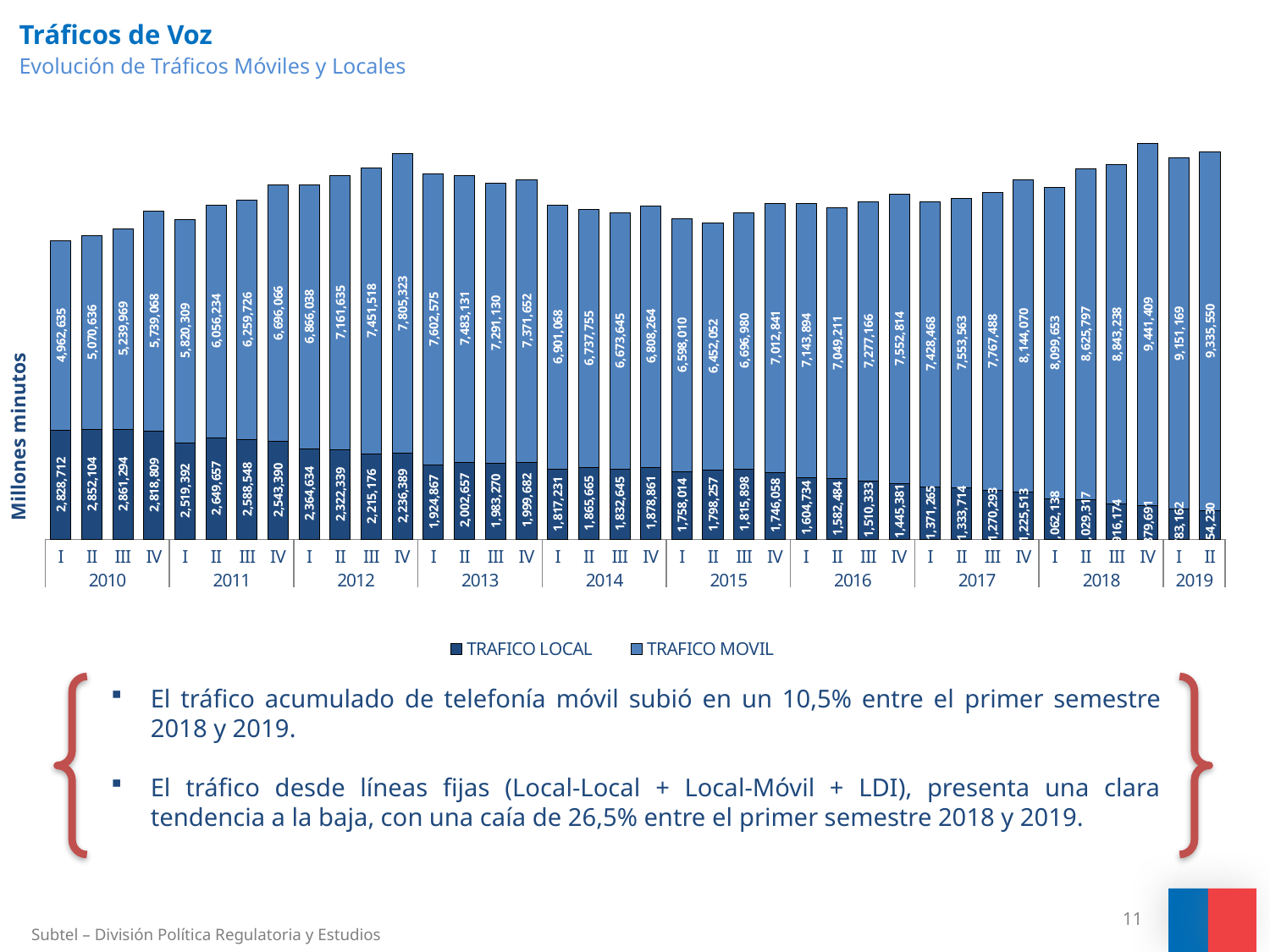
What is the TRAFICO MOVIL value for quarter IV of 2012? 7,805,323 What is the difference in TRAFICO MOVIL between quarter IV of 2018 and quarter III of 2018? 598,171 What is the TRAFICO MOVIL value for quarter II of 2019? 9,335,550 Which is larger, TRAFICO LOCAL in quarter I of 2010 or in quarter I of 2017? I 2010 In which quarter is TRAFICO MOVIL lowest? I 2010 What type of chart is shown on the slide? Stacked bar chart In which quarter is TRAFICO MOVIL highest? IV 2018 How many series does the legend list? 2 Does TRAFICO LOCAL rise or fall from 2010 to 2019? Fall What is the label on the vertical axis? Millones minutos What is the TRAFICO LOCAL value for quarter I of 2010? 2,828,712 What is the total of the stacked bar for quarter I of 2010? 7,791,347